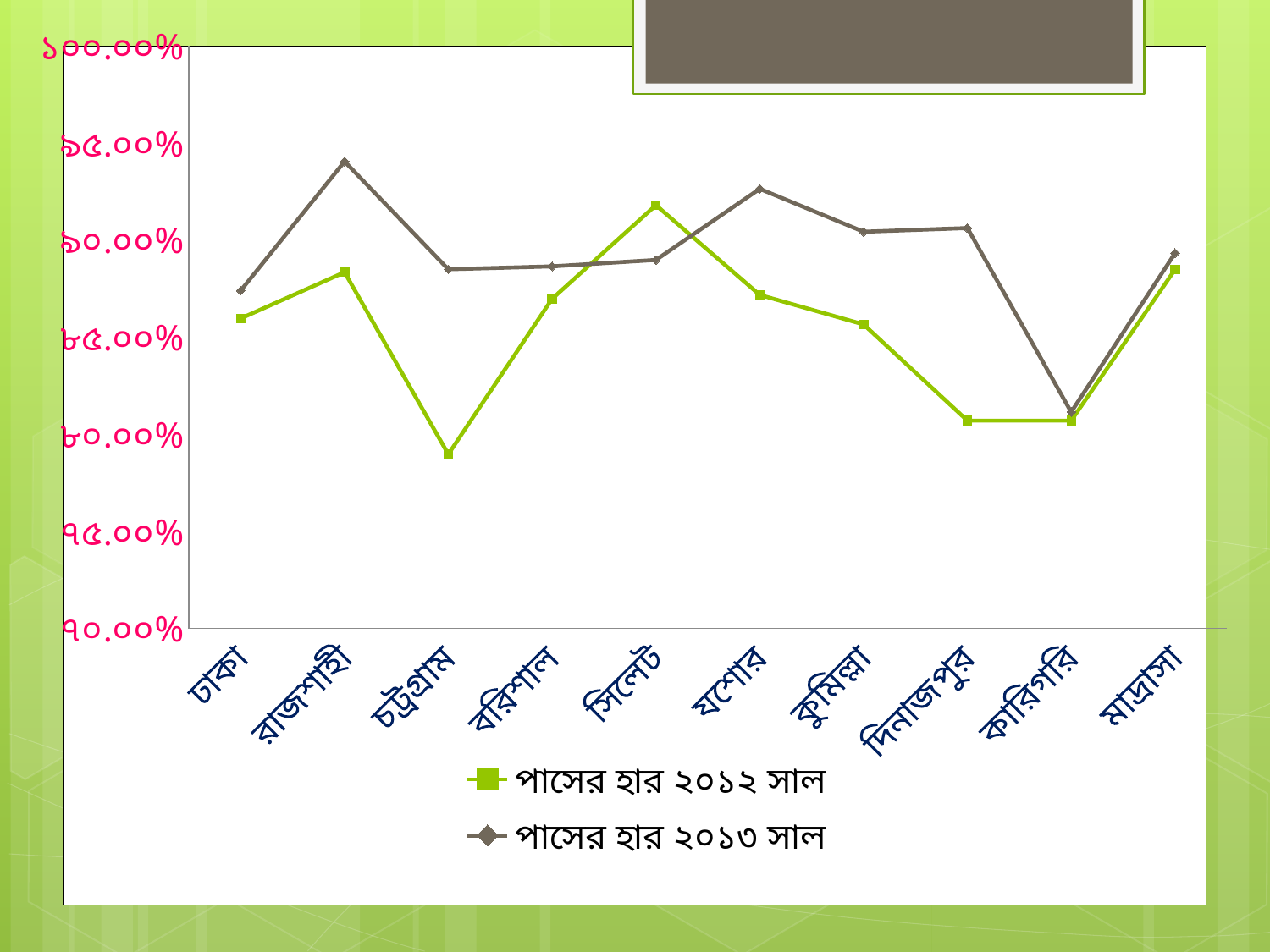
Is the value for কারিগরি in the series পাসের হার ২০১৩ সাল greater or less than ৮৫.০০%? less Which category has the highest value for the series পাসের হার ২০১২ সাল? সিলেট For রাজশাহী, which series has the larger value: পাসের হার ২০১২ সাল or পাসের হার ২০১৩ সাল? পাসের হার ২০১৩ সাল Which category has the lowest value for the series পাসের হার ২০১৩ সাল? কারিগরি Which category has the highest value for the series পাসের হার ২০১৩ সাল? রাজশাহী Is the value for রাজশাহী in the series পাসের হার ২০১৩ সাল greater or less than ৯০.০০%? greater For সিলেট, which series has the larger value: পাসের হার ২০১২ সাল or পাসের হার ২০১৩ সাল? পাসের হার ২০১২ সাল How many categories are shown on the x axis? 10 What kind of chart is shown on the slide? line chart How many series does the legend list? 2 Which category has the lowest value for the series পাসের হার ২০১২ সাল? চট্রগ্রাম Is the value for চট্টগ্রাম in the series পাসের হার ২০১২ সাল greater or less than ৮০.০০%? less